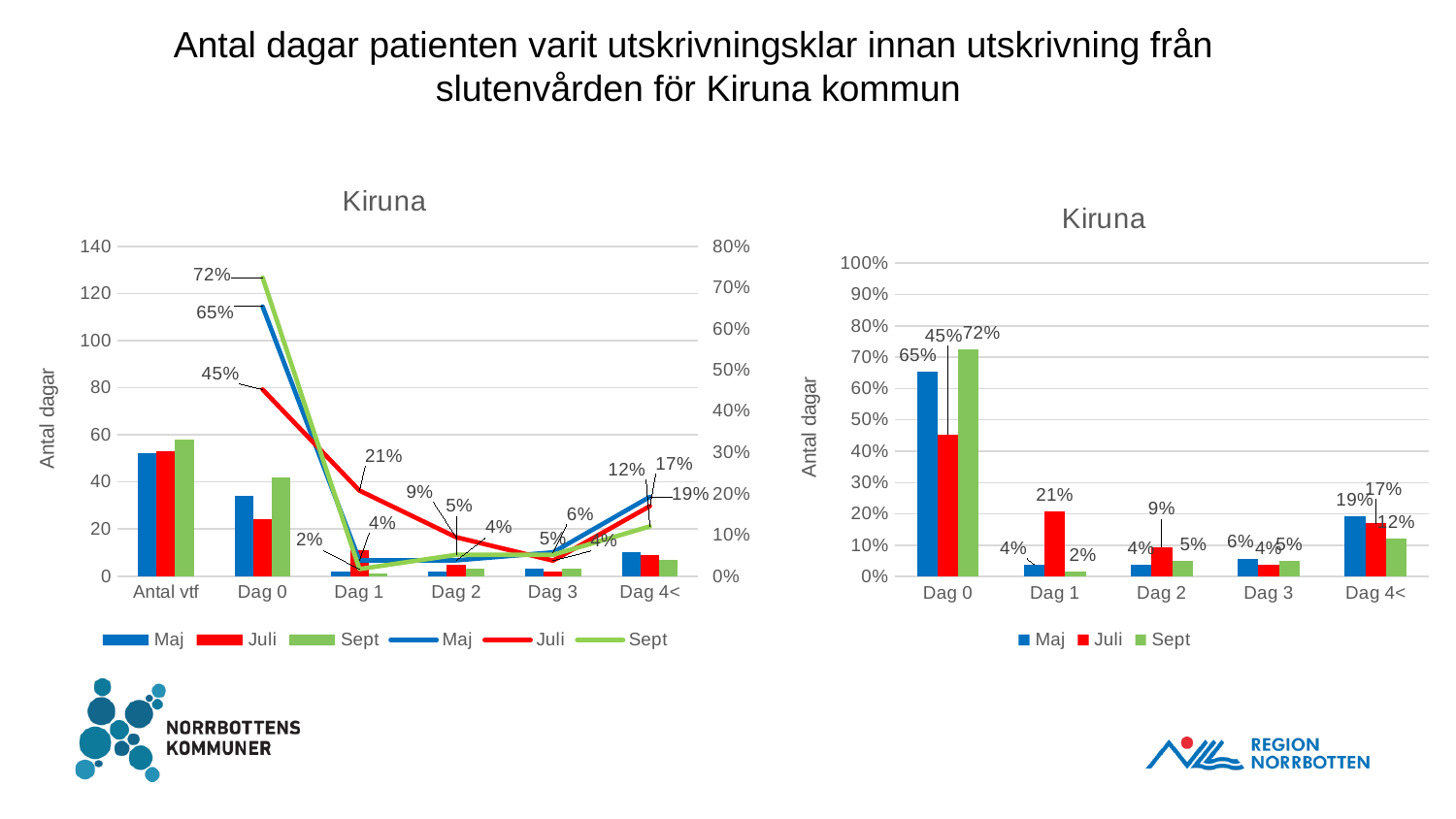
In the right-hand chart, what is the difference between the Sept and Maj values at Dag 0? 7% In the left-hand chart, is the Juli bar for Dag 0 greater or less than 40? less In the right-hand chart, what is the value for Juli at Dag 1? 21% In the right-hand chart, what is the value for Maj at Dag 0? 65% In the right-hand chart, what is the value for Sept at Dag 4<? 12% In the right-hand chart, which category has the highest value for Sept? Dag 0 How many categories are shown on the x axis of the left-hand chart? 6 In the right-hand chart, which is larger at Dag 4<: Maj or Juli? Maj How many categories are shown on the x axis of the right-hand chart? 5 In the left-hand chart, is the Sept bar for Antal vtf greater or less than 40? greater What kind of chart is the left-hand chart? Combination bar and line chart How many series does the legend of the right-hand chart list? 3